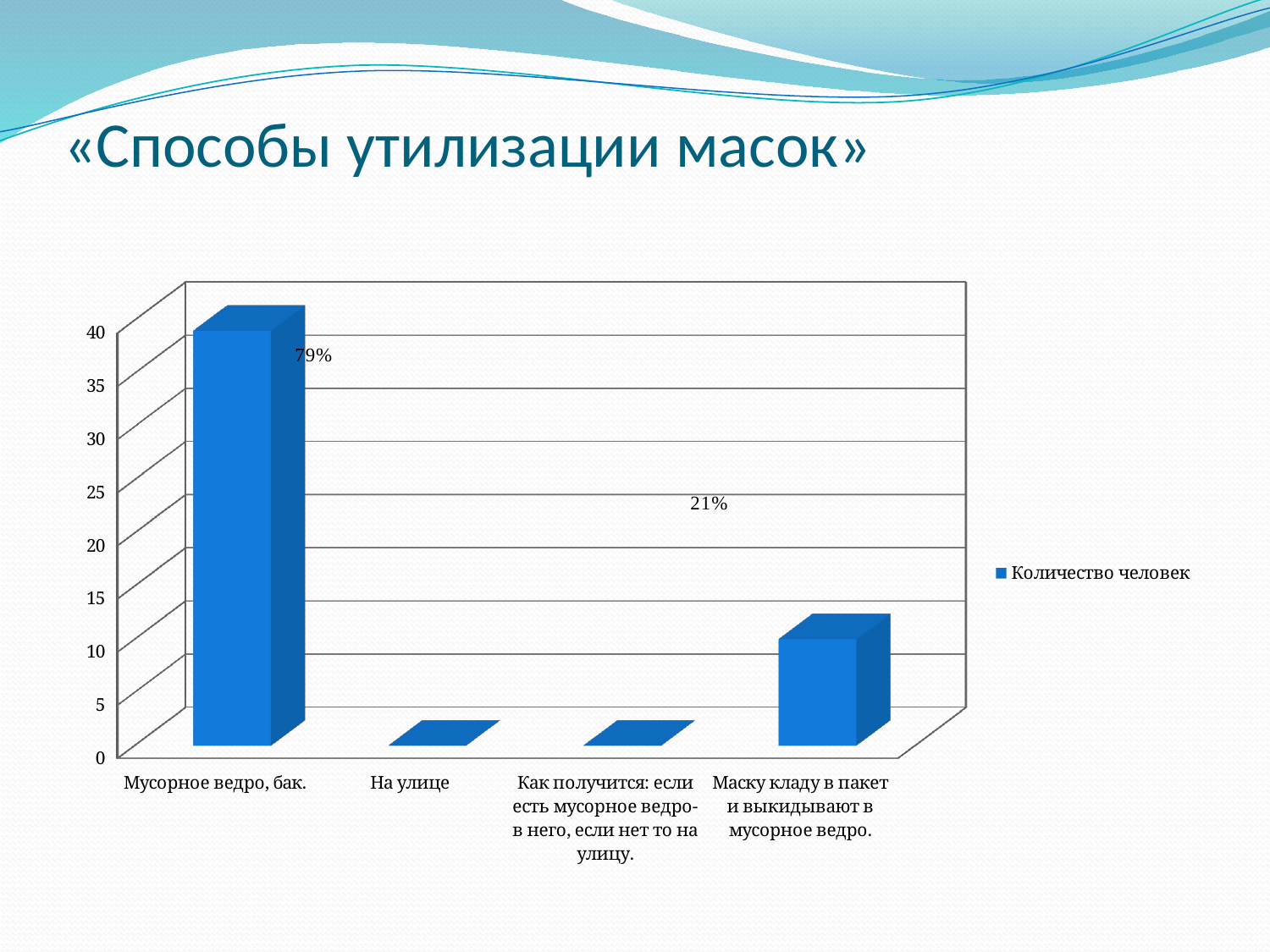
Is the value for "Мусорное ведро, бак." greater or less than 30? greater How many categories are shown on the x axis of the chart? 4 Is the value for "На улице" greater or less than 5? less What percentage label is shown next to the bar for "Мусорное ведро, бак."? 79% What is the name of the series in the chart legend? Количество человек Which category has the highest bar in the chart? Мусорное ведро, бак. Which is larger: the value for "Мусорное ведро, бак." or the value for "Маску кладу в пакет и выкидывают в мусорное ведро."? Мусорное ведро, бак. What is the title of the slide containing the chart? «Способы утилизации масок» Is the value for "Маску кладу в пакет и выкидывают в мусорное ведро." greater or less than 5? greater How many series does the chart legend list? 1 What kind of chart is shown on the slide? bar chart